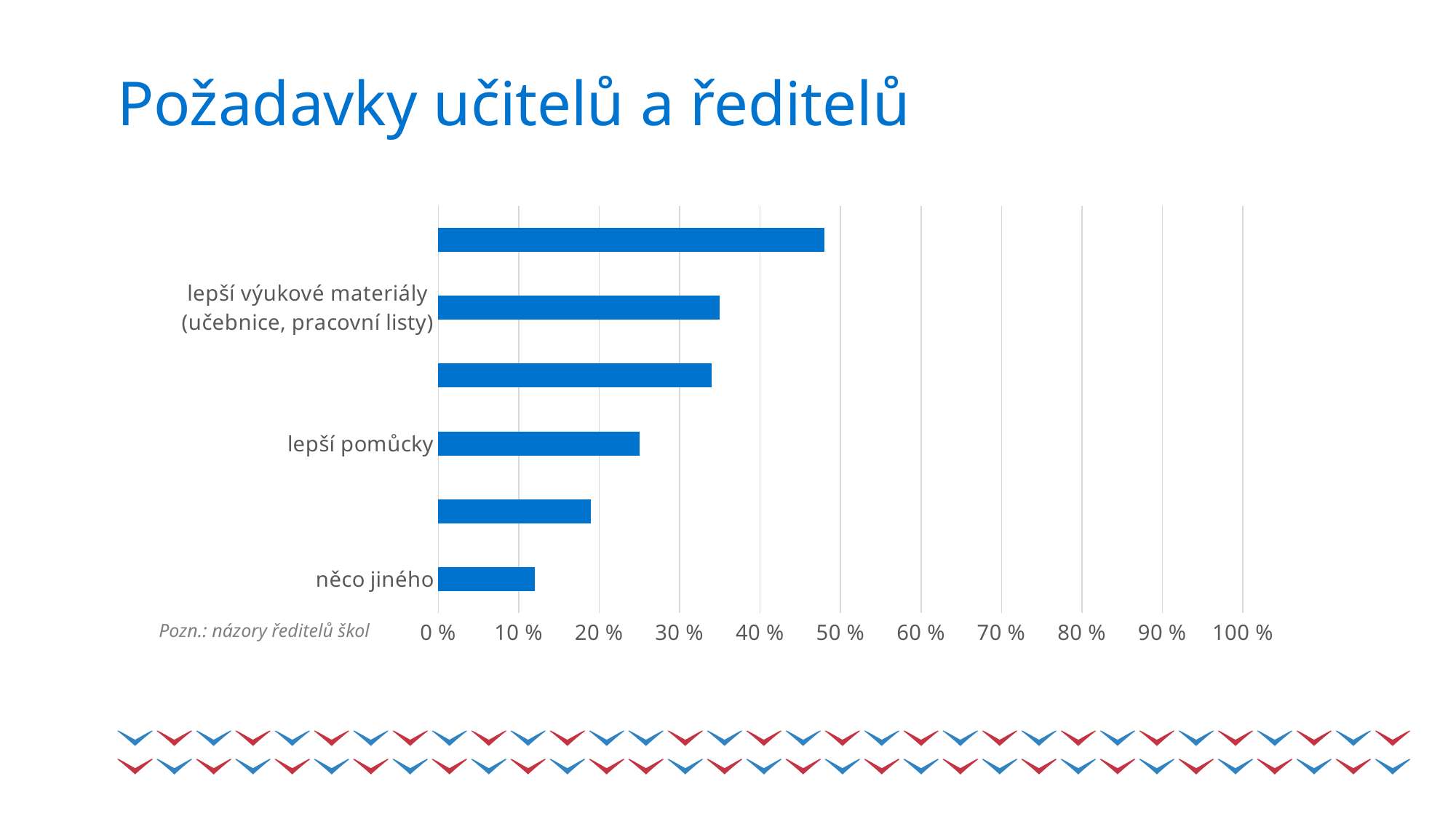
Is the value for něco jiného greater or less than 20 %? less Is the value for lepší výukové materiály (učebnice, pracovní listy) greater or less than 30 %? greater Which is larger, the value for lepší výukové materiály (učebnice, pracovní listy) or the value for lepší pomůcky? lepší výukové materiály (učebnice, pracovní listy) Is the value for lepší pomůcky greater or less than 30 %? less Which is larger, the value for lepší pomůcky or the value for něco jiného? lepší pomůcky What is the highest value shown on the chart's horizontal axis? 100 % How many bars does the chart contain? 6 Which labelled category has the lowest value? něco jiného Do the bar values increase or decrease from the top bar to the bottom bar? decrease What kind of chart is shown on the slide? bar chart What is the title of the slide containing the chart? Požadavky učitelů a ředitelů